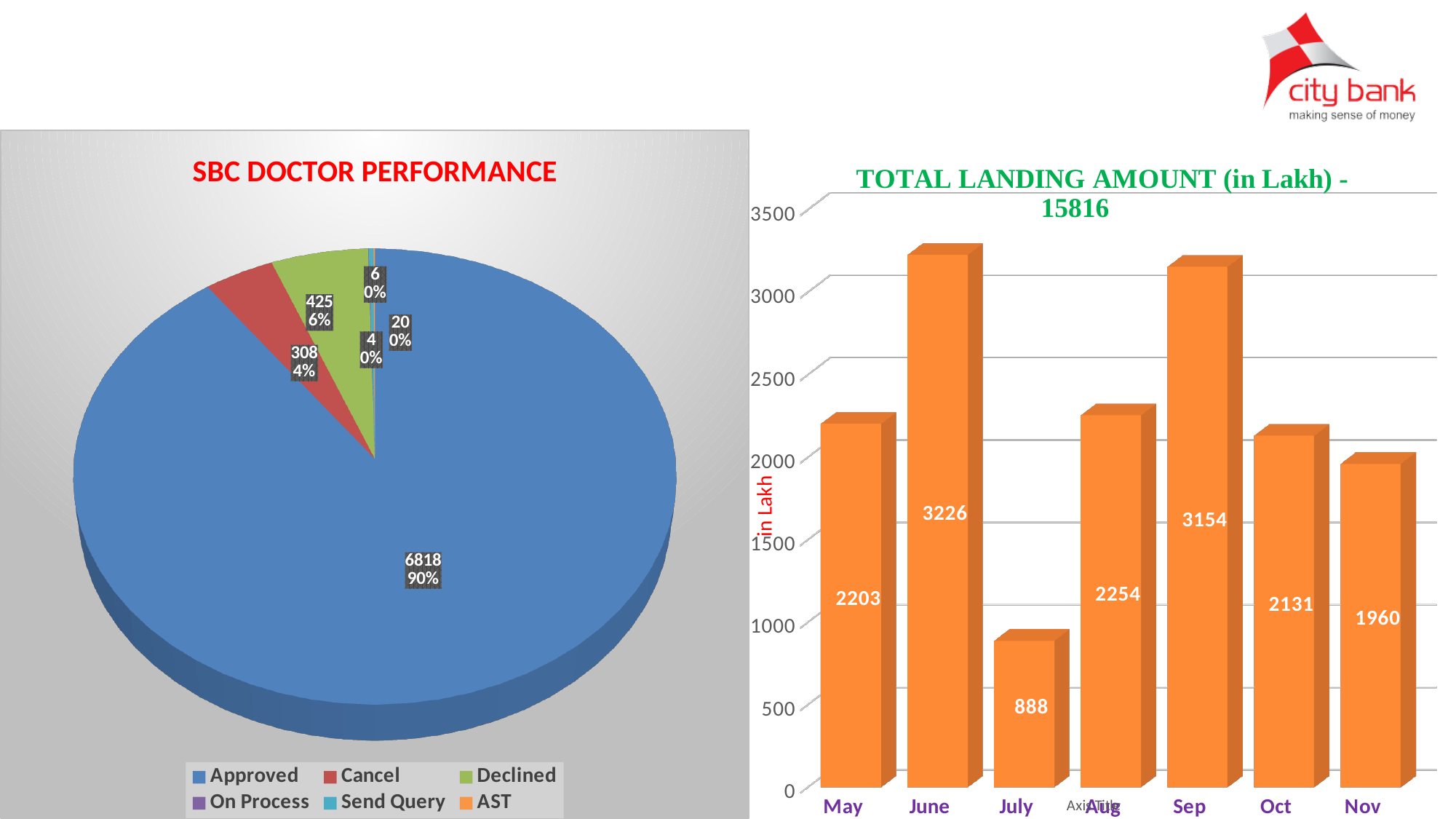
In the TOTAL LANDING AMOUNT chart, what is the difference between the values for June and Sep? 72 In the TOTAL LANDING AMOUNT chart, what is the value for June? 3226 In the SBC DOCTOR PERFORMANCE chart, what share of the pie is Approved? 90% How many entries does the legend of the SBC DOCTOR PERFORMANCE chart list? 6 How many months are shown in the TOTAL LANDING AMOUNT chart? 7 What kind of chart is the TOTAL LANDING AMOUNT chart? bar chart In the SBC DOCTOR PERFORMANCE chart, what share of the pie is Declined? 6% In the TOTAL LANDING AMOUNT chart, which is larger, the value for Aug or the value for May? Aug In the TOTAL LANDING AMOUNT chart, which month has the highest value? June In the TOTAL LANDING AMOUNT chart, what is the value for July? 888 In the TOTAL LANDING AMOUNT chart, which month has the lowest value? July In the SBC DOCTOR PERFORMANCE chart, what is the value for Approved? 6818